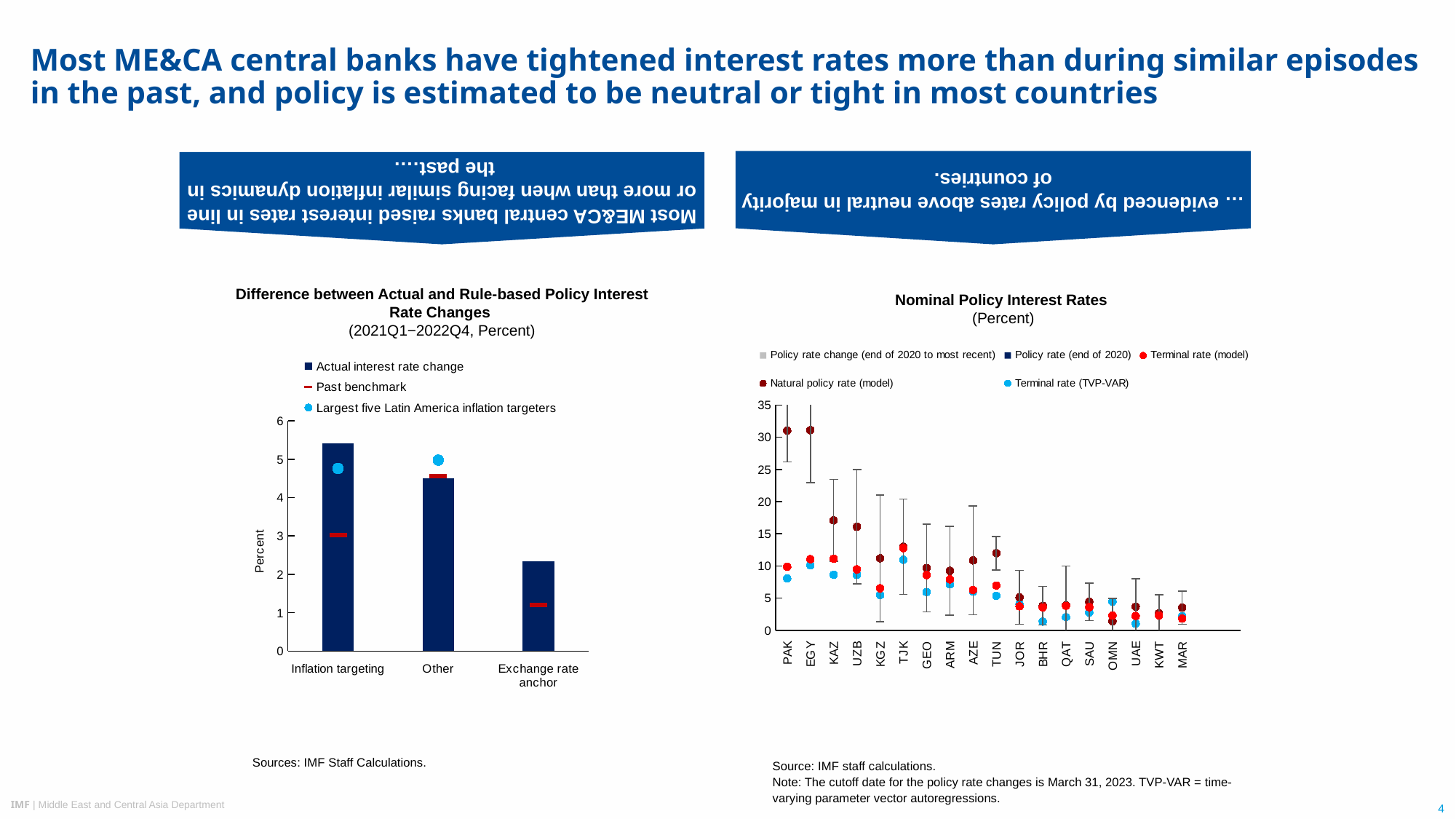
What kind of chart is the left chart, 'Difference between Actual and Rule-based Policy Interest Rate Changes'? Bar chart In the right chart, 'Nominal Policy Interest Rates', do the natural policy rate values generally rise or fall moving from PAK on the left to MAR on the right? Fall In the left chart, 'Difference between Actual and Rule-based Policy Interest Rate Changes', is the actual interest rate change for Inflation targeting greater or less than 5? greater In the left chart, 'Difference between Actual and Rule-based Policy Interest Rate Changes', is the actual interest rate change for Exchange rate anchor greater or less than 3? less In the left chart, 'Difference between Actual and Rule-based Policy Interest Rate Changes', which category has the highest actual interest rate change? Inflation targeting In the left chart, 'Difference between Actual and Rule-based Policy Interest Rate Changes', which has a larger actual interest rate change: Inflation targeting or Other? Inflation targeting In the right chart, 'Nominal Policy Interest Rates', is the natural policy rate (model) for PAK greater or less than 25? greater In the left chart, 'Difference between Actual and Rule-based Policy Interest Rate Changes', how many categories are shown on the x axis? 3 In the right chart, 'Nominal Policy Interest Rates', how many countries are shown on the x axis? 18 How many series does the legend of the right chart, 'Nominal Policy Interest Rates', list? 5 In the left chart, 'Difference between Actual and Rule-based Policy Interest Rate Changes', which category has the lowest actual interest rate change? Exchange rate anchor How many series does the legend of the left chart, 'Difference between Actual and Rule-based Policy Interest Rate Changes', list? 3